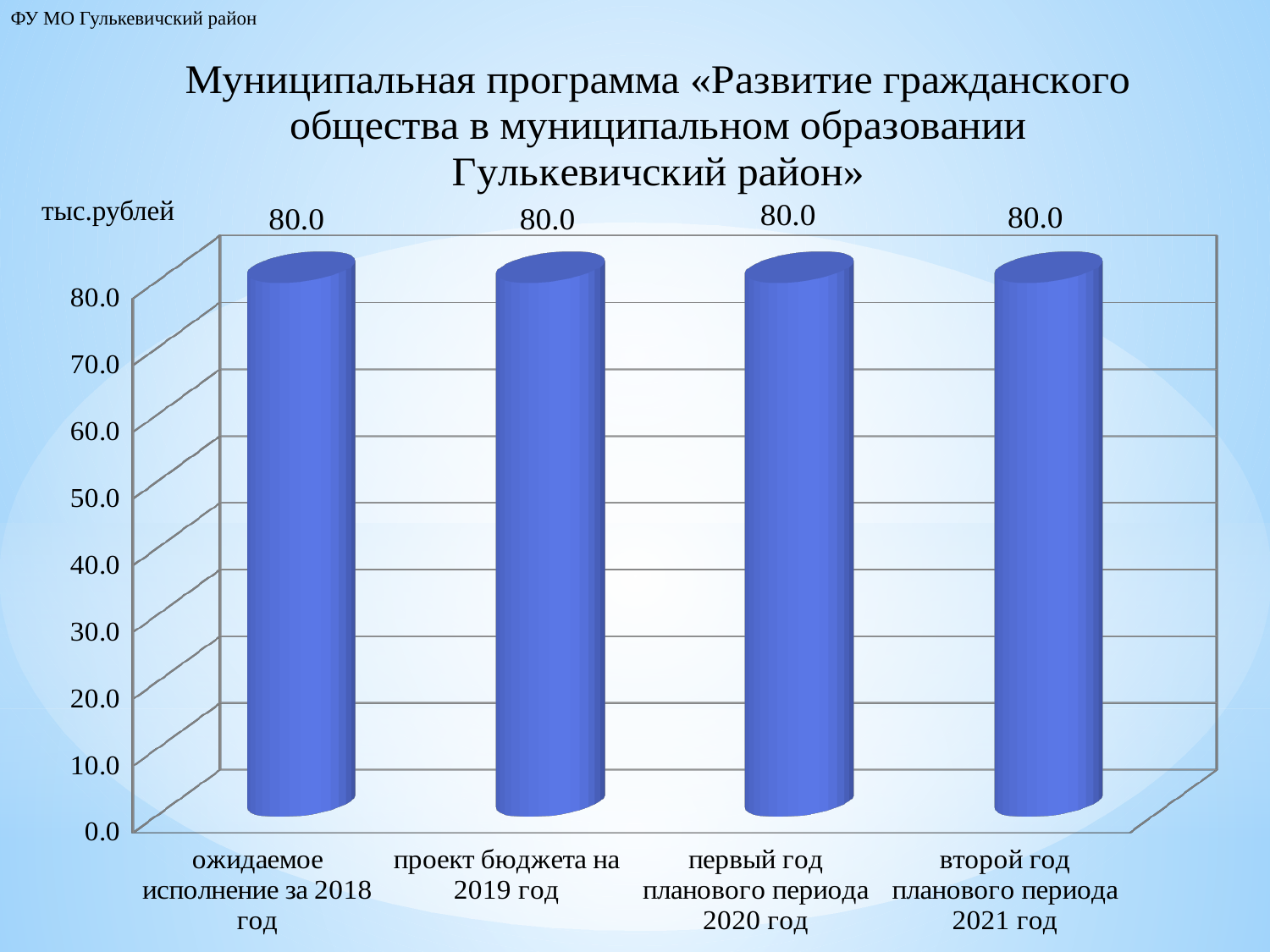
Is the value for «второй год планового периода 2021 год» greater or less than 70.0? greater What kind of chart is shown on the slide? bar chart What is the name of the municipal programme in the chart title? «Развитие гражданского общества в муниципальном образовании Гулькевичский район» What is the value for «первый год планового периода 2020 год»? 80.0 Do the values rise, fall or stay the same from 2018 to 2021? stay the same What is the difference between the value for «проект бюджета на 2019 год» and the value for «ожидаемое исполнение за 2018 год»? 0.0 What is the value for «ожидаемое исполнение за 2018 год»? 80.0 What unit of measurement is indicated for the chart values? тыс.рублей What is the value for «проект бюджета на 2019 год»? 80.0 What is the value for «второй год планового периода 2021 год»? 80.0 How many categories are shown on the x axis of the chart? 4